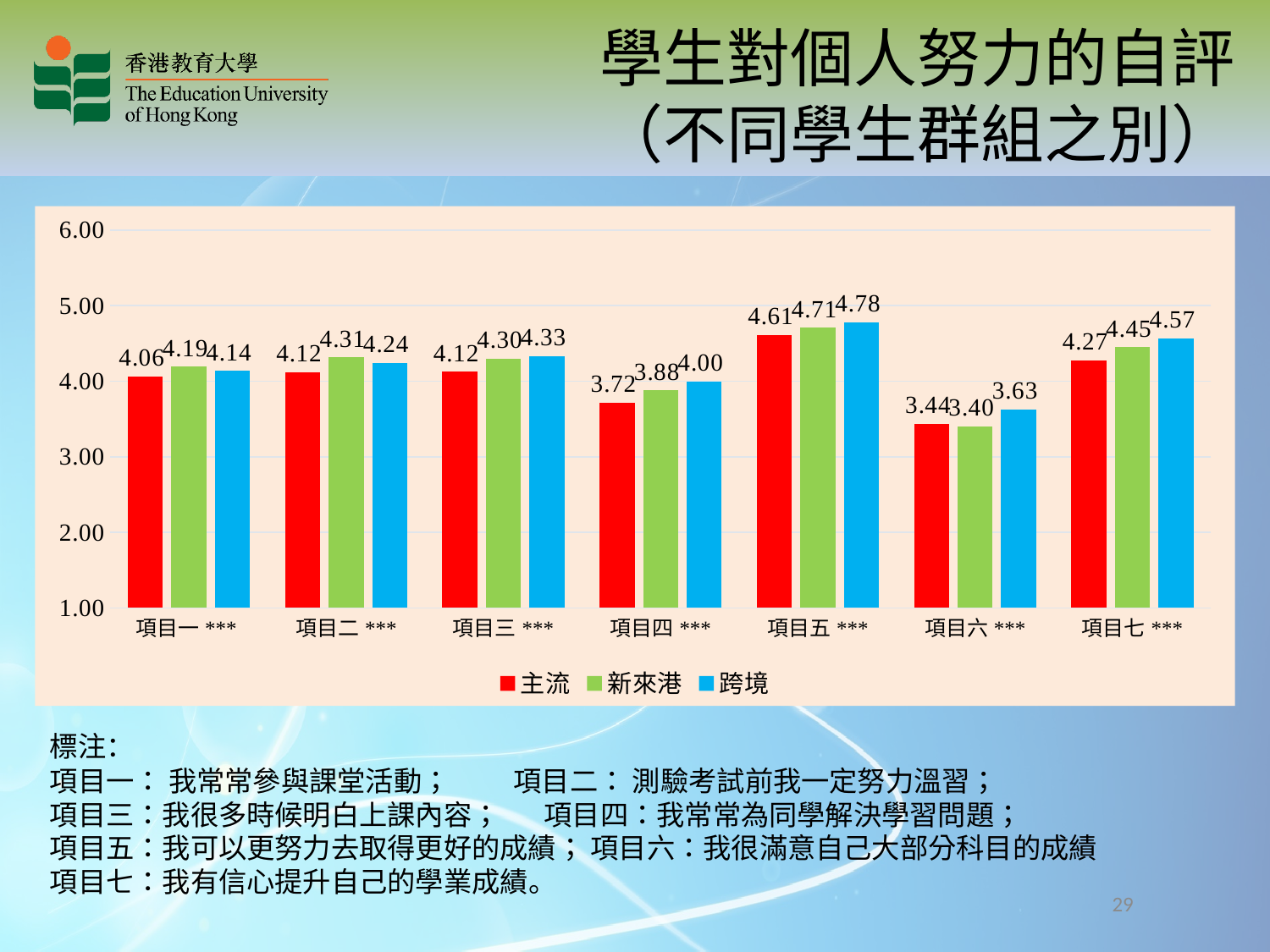
Is the value for 主流 in 項目四 *** greater or less than 4.00? less What is the value for 主流 in 項目五 ***? 4.61 Which series is shown in red in the legend? 主流 What is the difference between the 跨境 and 主流 values in 項目七 ***? 0.30 Which category has the lowest value for 主流? 項目六 *** In 項目二 ***, which is larger: the value for 新來港 or the value for 跨境? 新來港 What kind of chart is shown on the slide? bar chart What is the value for 新來港 in 項目六 ***? 3.40 What is the value for 跨境 in 項目四 ***? 4.00 How many series does the legend list? 3 How many categories are shown on the x axis? 7 Which category has the highest value for 跨境? 項目五 ***